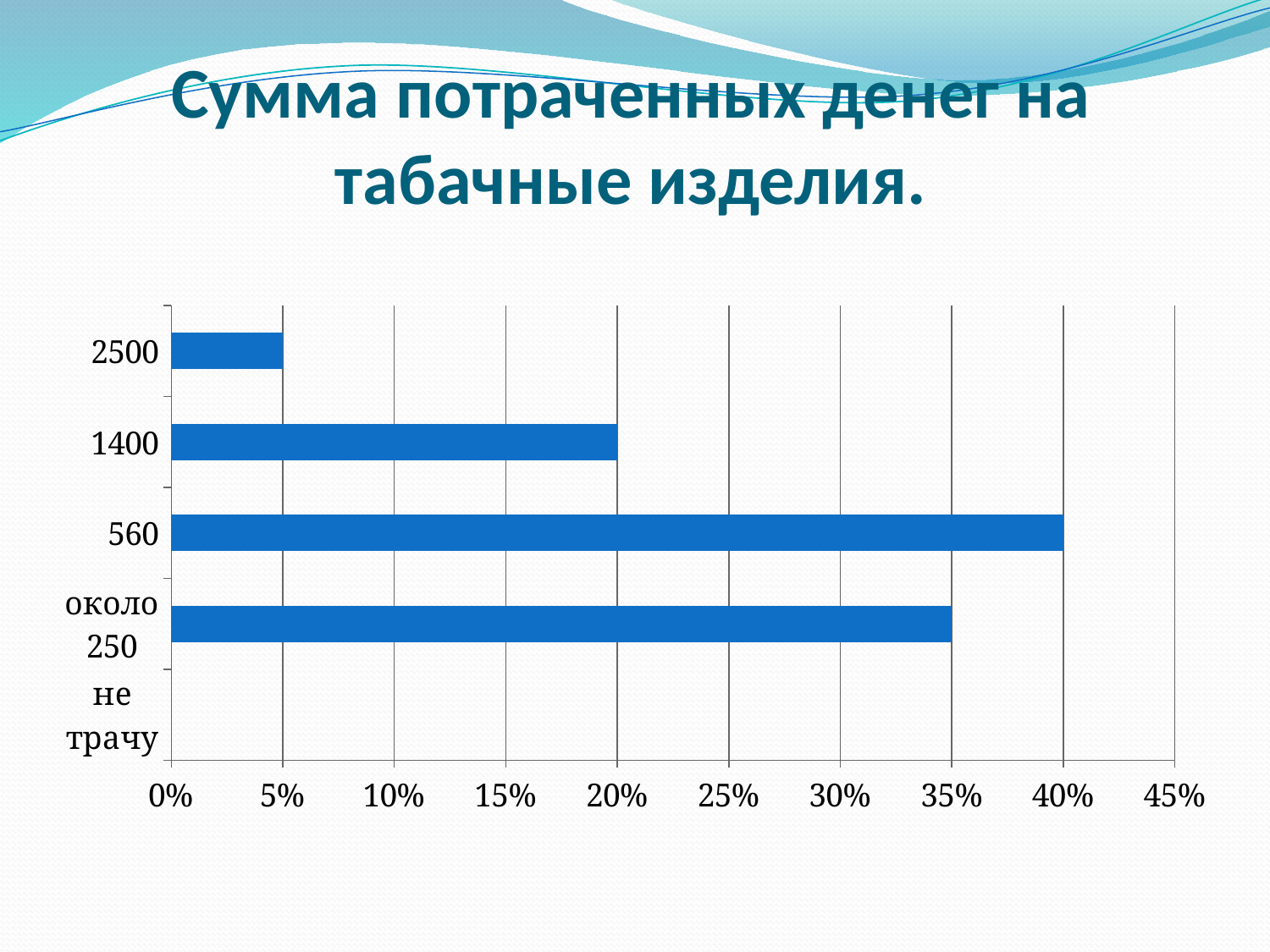
What is the difference between the values for 560 and около 250? 5% Which category with a visible bar has the lowest value? 2500 Which is larger, the value for 1400 or the value for около 250? около 250 What is the value for the category 560? 40% What is the value for the category около 250? 35% What is the difference between the values for 1400 and 2500? 15% What type of chart is shown on the slide? bar chart Which category has the highest value? 560 How many categories are listed on the vertical axis? 5 What is the value for the category 1400? 20% What is the title of the chart? Сумма потраченных денег на табачные изделия. What is the value for the category 2500? 5%